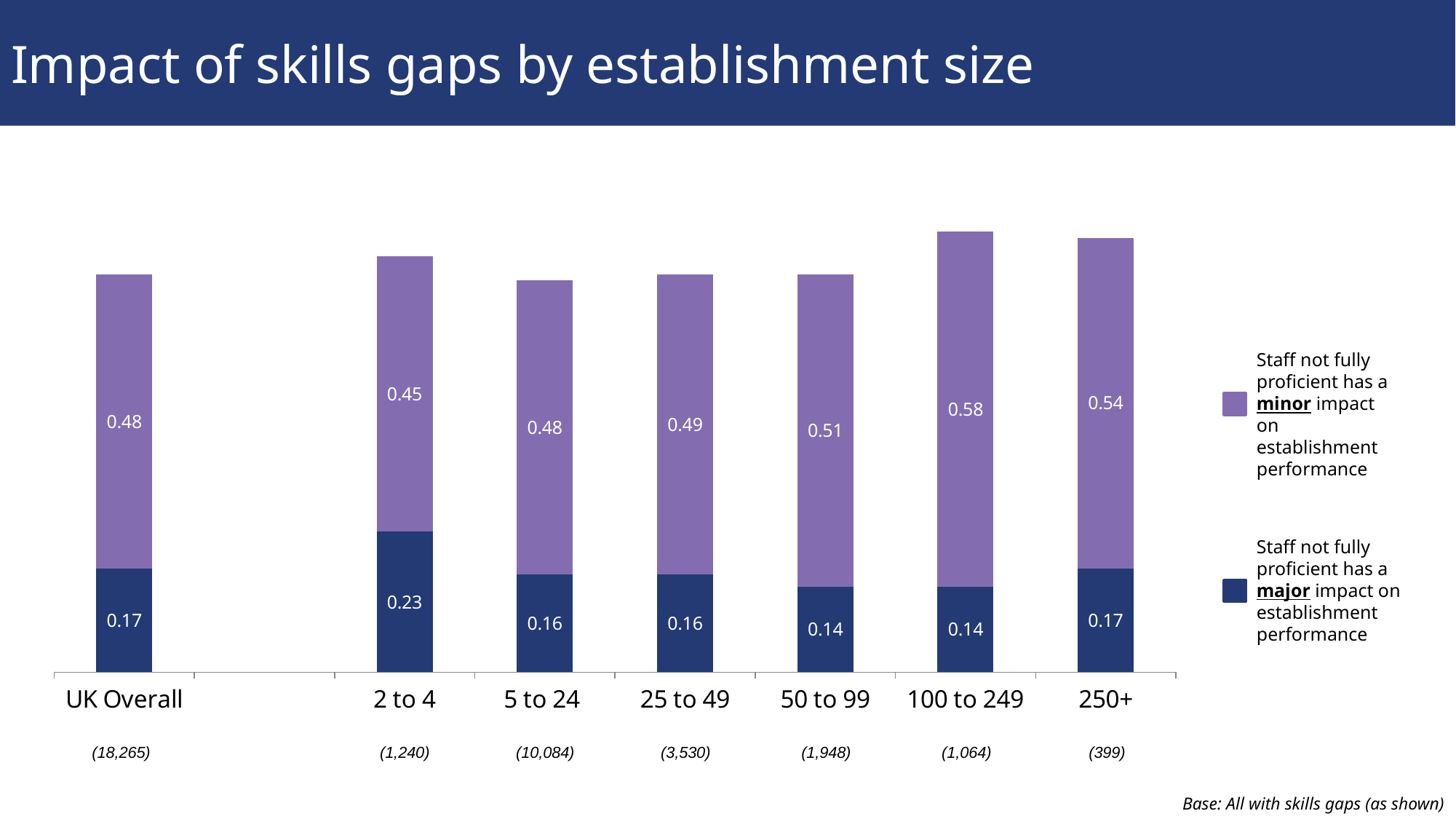
How many establishment size categories are shown on the x axis? 7 What is the value for 'major impact' for the 2 to 4 establishment size? 0.23 Which establishment size has the highest 'minor impact' value? 100 to 249 What is the total of the stacked bar for UK Overall? 0.65 Which is larger, the 'major impact' value for 250+ or for 50 to 99? 250+ What is the total of the stacked bar for 250+? 0.71 What kind of chart is shown on the slide? Stacked bar chart How many series does the legend list? 2 What is the value for 'minor impact' for UK Overall? 0.48 Which establishment size has the highest 'major impact' value? 2 to 4 What is the value for 'minor impact' for the 100 to 249 establishment size? 0.58 What is the difference between the 'minor impact' values for 100 to 249 and 2 to 4? 0.13